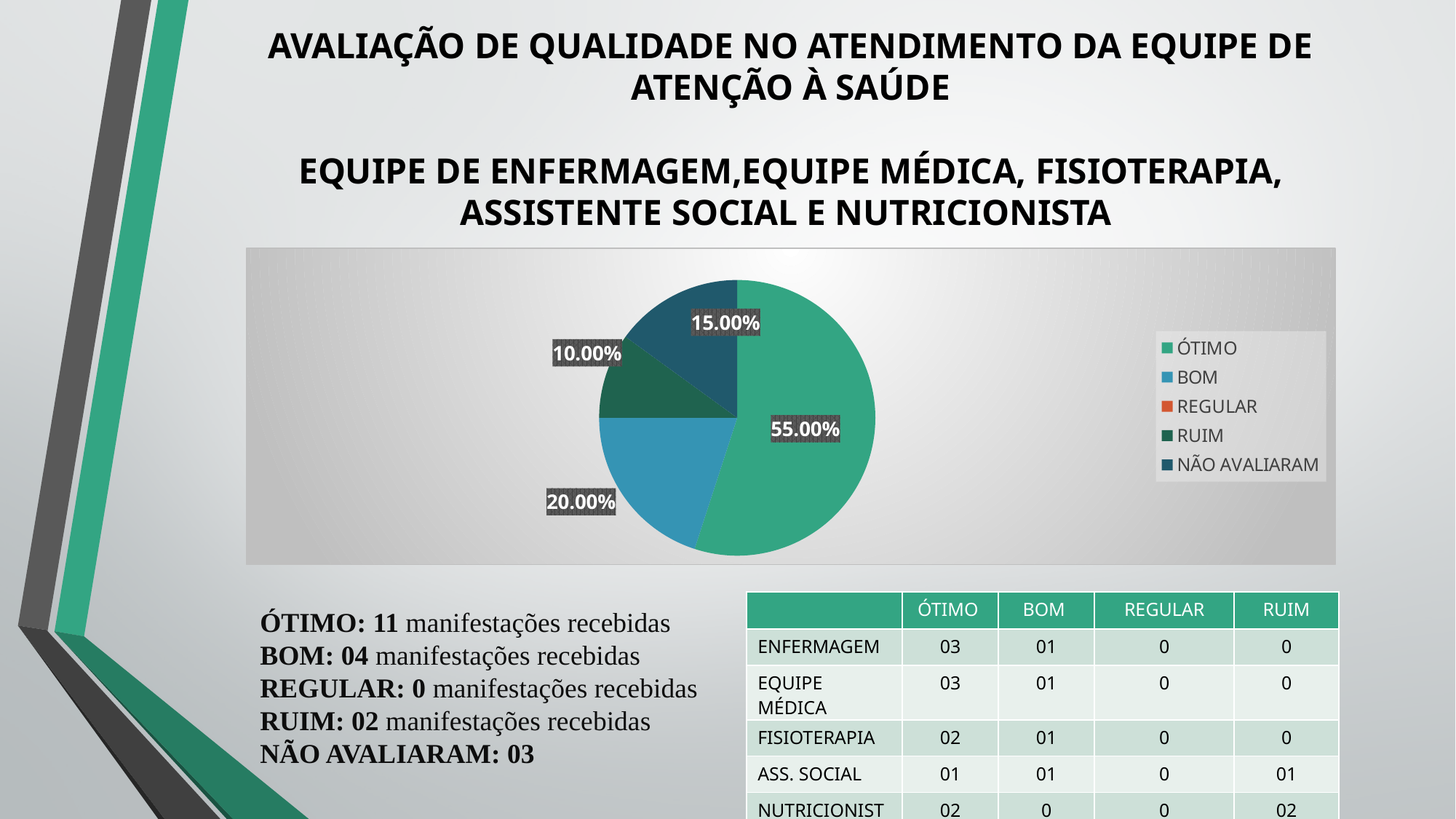
Which legend entry is shown in orange? REGULAR What percentage of the pie chart is labelled for NÃO AVALIARAM? 15.00% Which category has the smallest visible slice of the pie chart? RUIM How many entries does the legend of the pie chart list? 5 What percentage of the pie chart is labelled for BOM? 20.00% What is the difference in percentage points between the ÓTIMO slice and the BOM slice? 35.00% What is the combined share of the BOM and RUIM slices? 30.00% What percentage of the pie chart is labelled for ÓTIMO? 55.00% Which slice is larger, NÃO AVALIARAM or RUIM? NÃO AVALIARAM What percentage of the pie chart is labelled for RUIM? 10.00% Which category has the largest slice of the pie chart? ÓTIMO What kind of chart is shown on the slide? pie chart